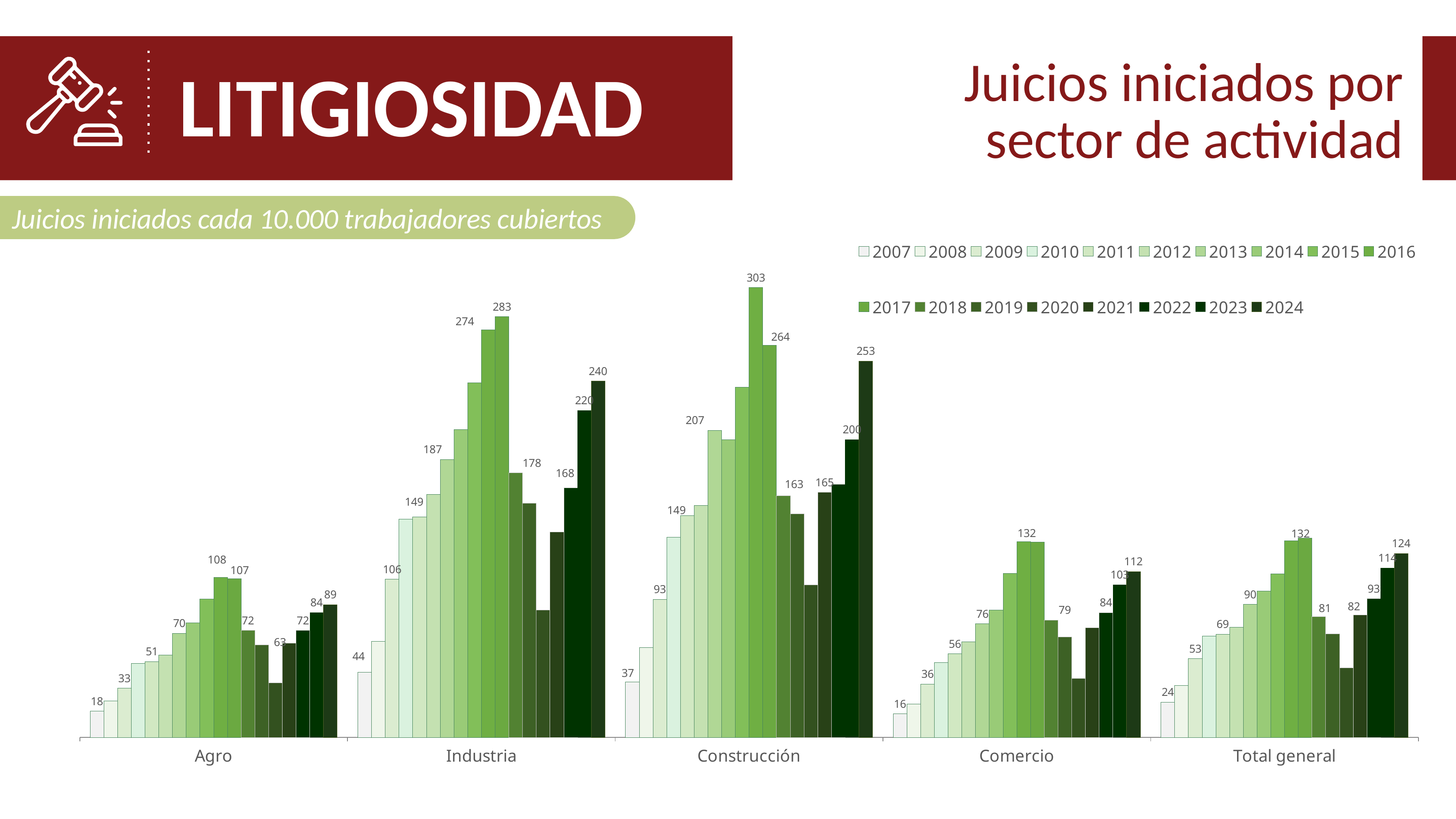
What is the value for Construcción in 2024? 253 What is the highest value shown for Construcción? 303 What type of chart is shown? Bar chart What is the difference between the 2024 and 2023 values for Construcción? 53 Which is larger in 2024: Comercio or Total general? Total general What is the value for Agro in 2007? 18 How many years (series) does the legend list? 18 How many sector categories are shown on the x axis? 5 Which sector has the lowest 2007 value? Comercio What is the value for Industria in 2023? 220 What is the value for Comercio in 2024? 112 Which sector has the highest single value in the chart? Construcción